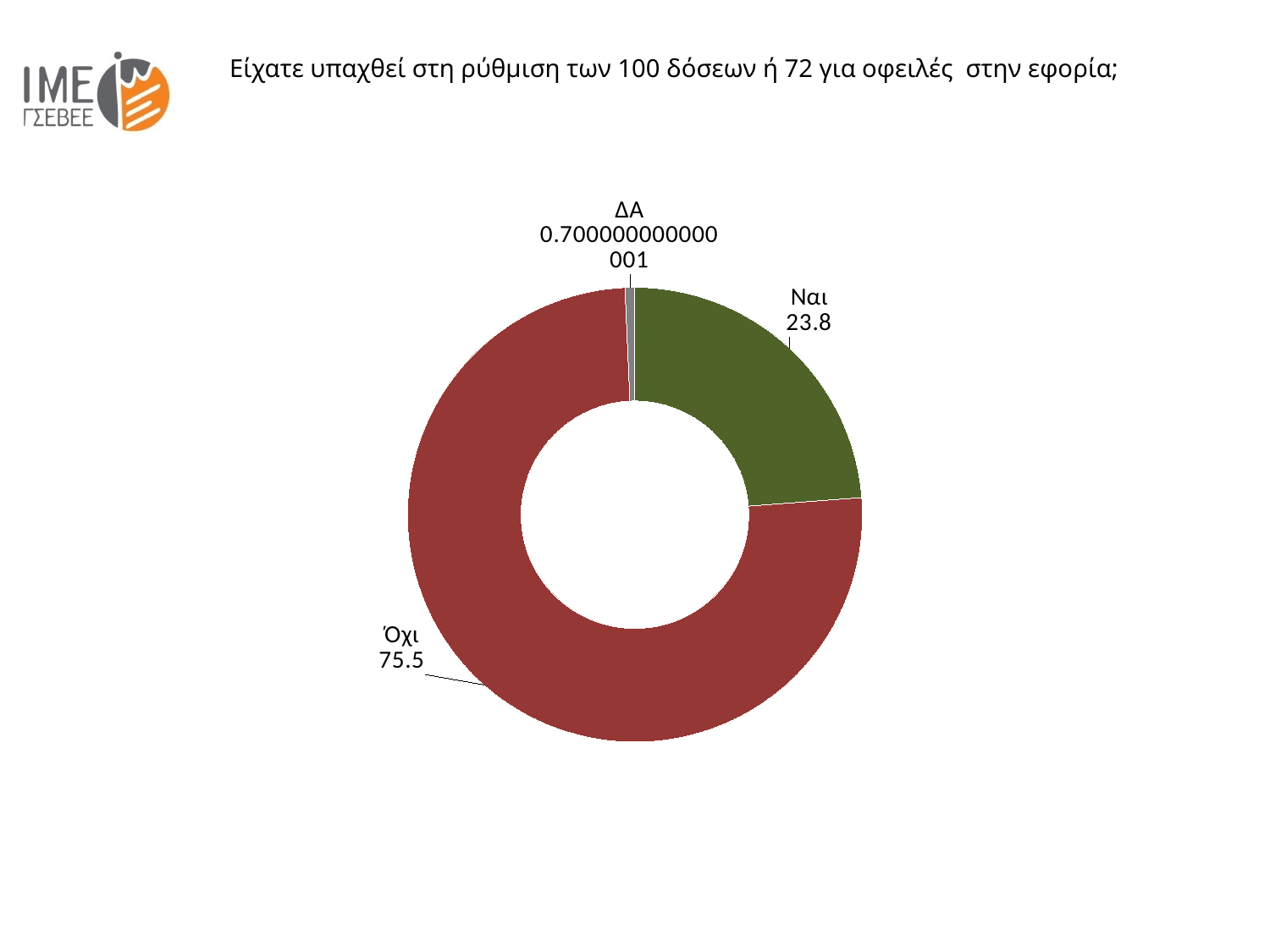
Which category has the largest slice? Όχι How many categories (slices) does the chart have? 3 What type of chart is shown on the slide? Doughnut (pie) chart Which is larger, the value for Ναι or the value for Όχι? Όχι What colour is the Ναι slice? Green What is the difference between the values for Όχι and Ναι? 51.7 What is the value for Όχι? 75.5 What is the value for Ναι? 23.8 What is the value printed for ΔΑ? 0.700000000000001 What is the title of the chart? Είχατε υπαχθεί στη ρύθμιση των 100 δόσεων ή 72 για οφειλές στην εφορία; Which category has the smallest slice? ΔΑ What share of the chart does the Όχι slice represent? 75.5